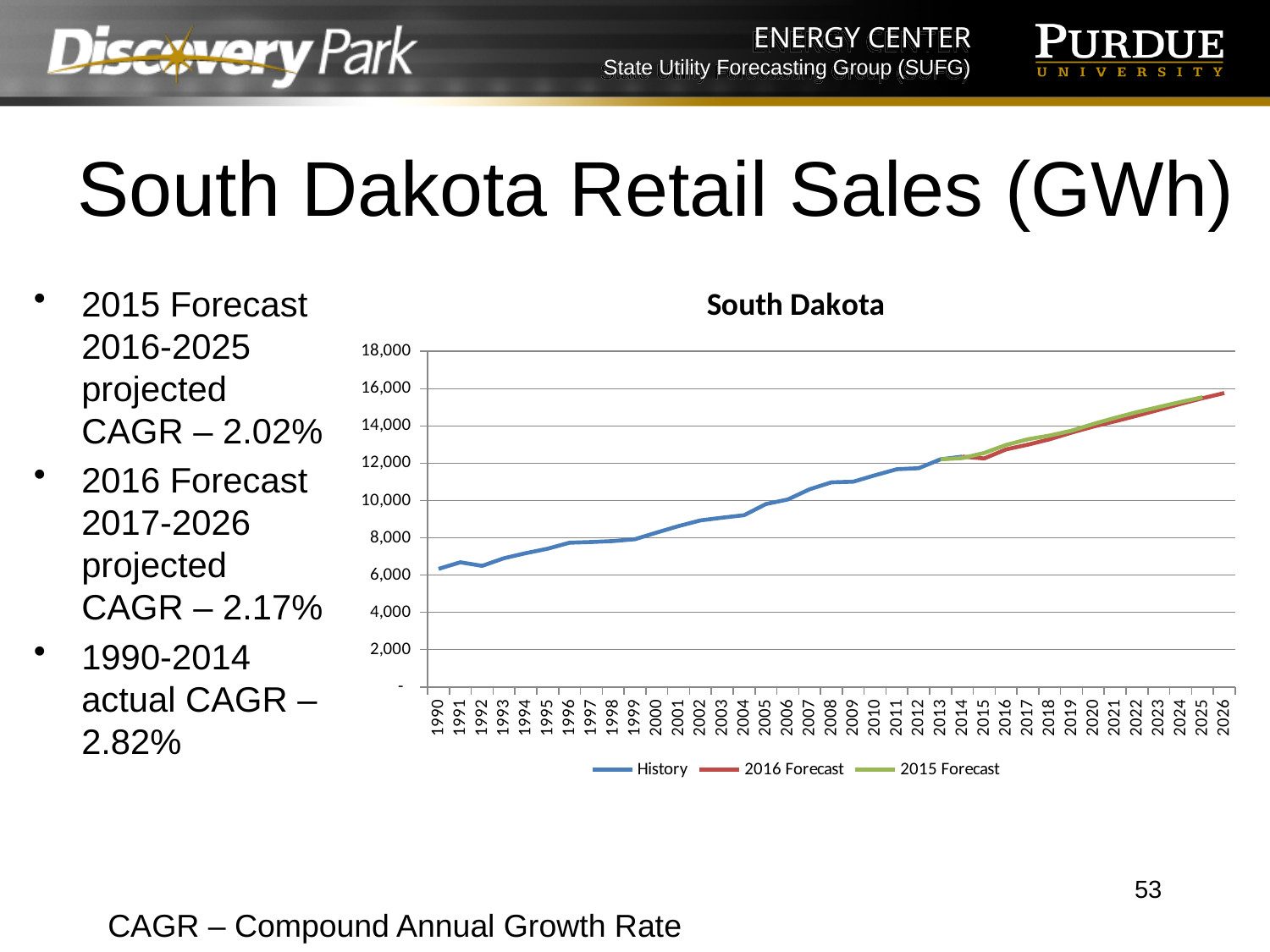
Is the value for 2026 in the South Dakota chart greater or less than 14,000? greater How many series does the legend of the South Dakota chart list? 3 Do the values in the South Dakota chart generally rise or fall from 1990 to 2026? rise In the South Dakota chart, which year has the larger value, 1990 or 2026? 2026 How many years are shown on the x axis of the South Dakota chart? 37 Which series in the South Dakota chart is drawn in blue? History What is the title of the chart on the slide? South Dakota Is the History value for 1990 in the South Dakota chart greater or less than 8,000? less Is the History value for 2010 in the South Dakota chart greater or less than 10,000? greater What kind of chart is shown on the slide? line chart What is the last year shown on the x axis of the South Dakota chart? 2026